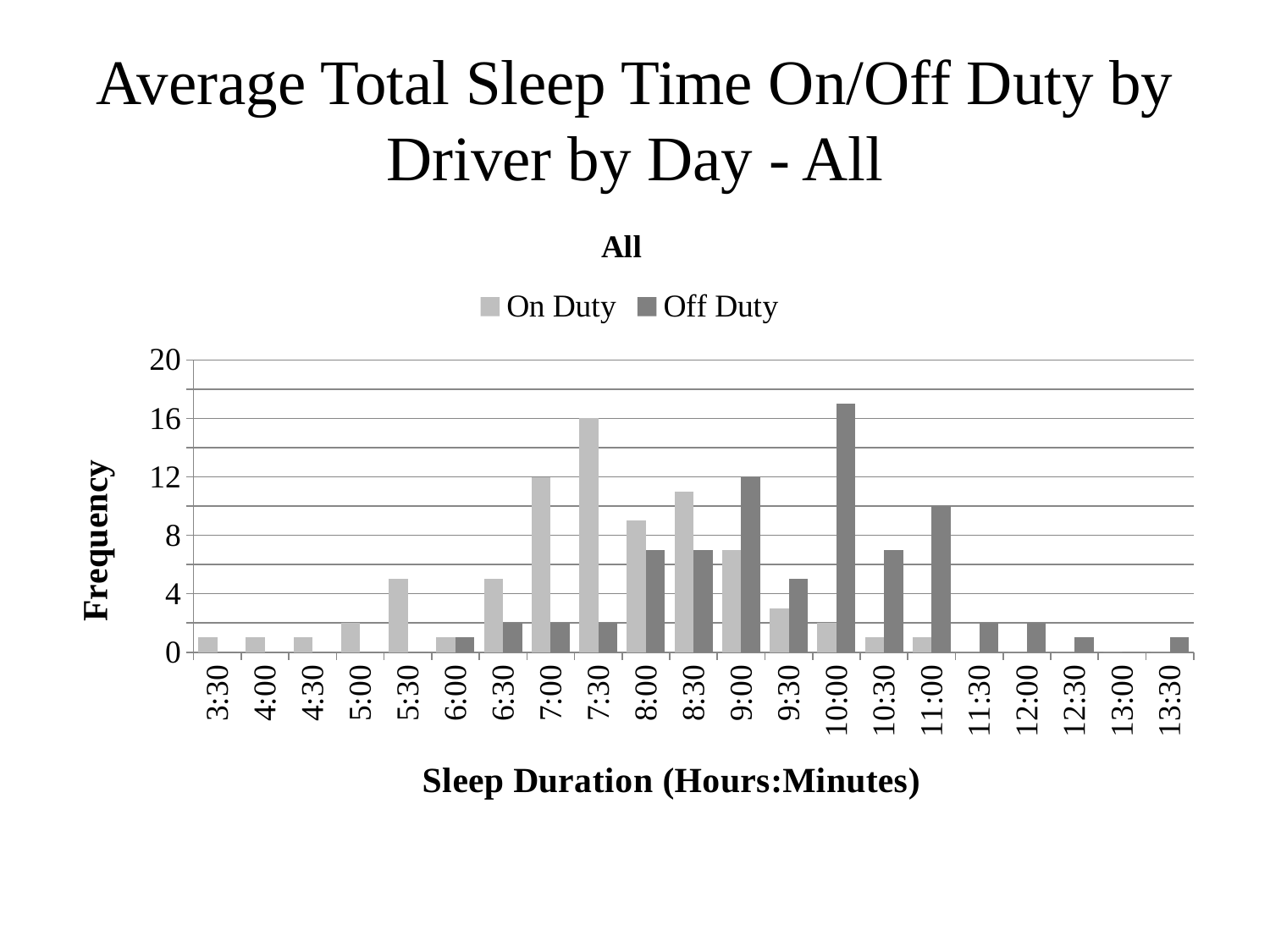
What type of chart is shown on the slide? bar chart At a sleep duration of 9:00, which series has the larger frequency, On Duty or Off Duty? Off Duty What is the On Duty frequency for a sleep duration of 7:30? 16 At a sleep duration of 8:00, which series has the larger frequency, On Duty or Off Duty? On Duty Is the Off Duty frequency for 10:00 greater or less than 16? greater What is the title of the vertical axis? Frequency Which sleep duration has the highest Off Duty frequency? 10:00 Which sleep duration has the highest On Duty frequency? 7:30 How many series does the legend list? 2 What is the Off Duty frequency for a sleep duration of 9:00? 12 Is the On Duty frequency for 8:30 greater or less than 8? greater How many sleep duration categories are shown on the x axis? 21